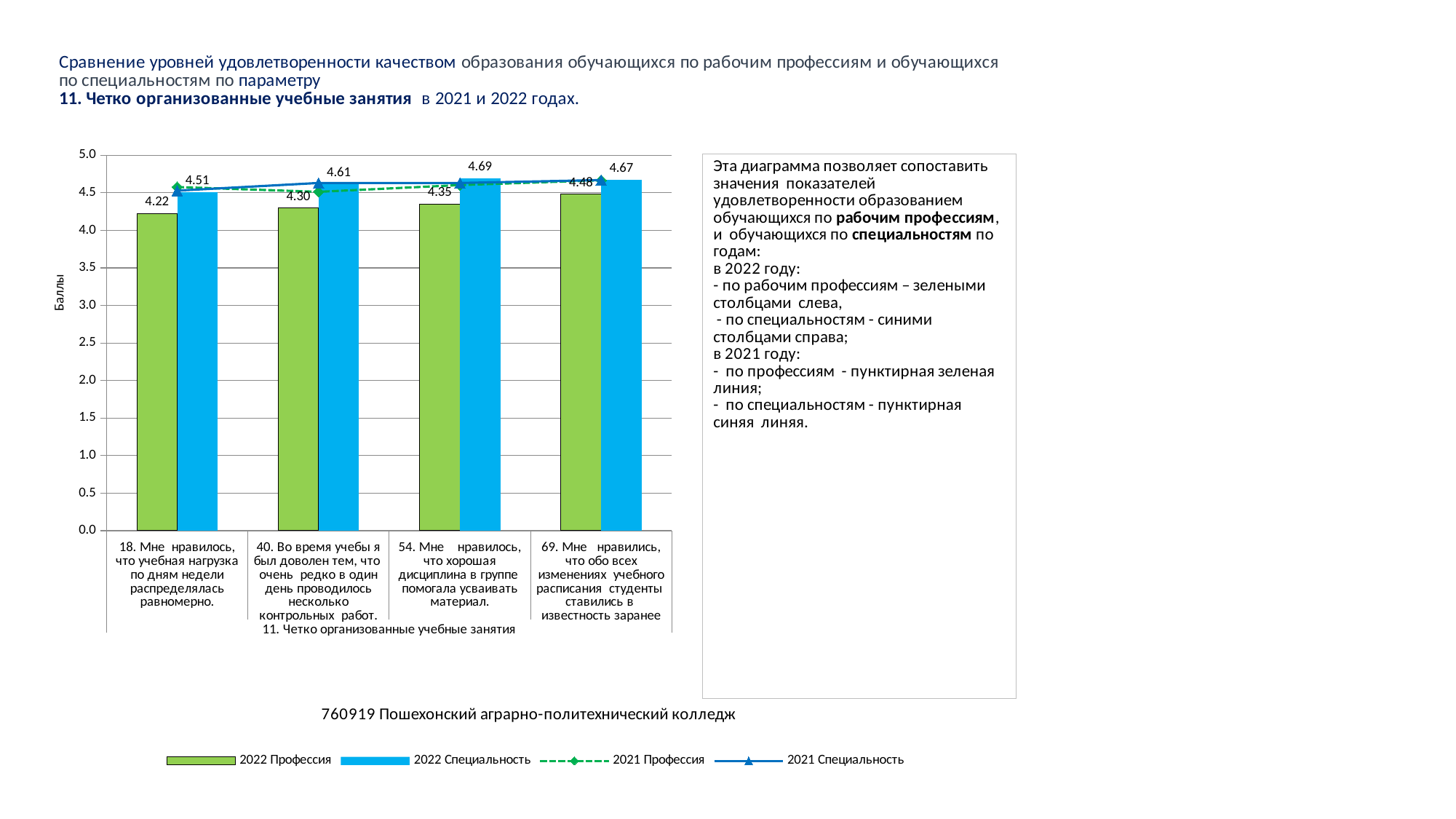
Which category has the lowest 2022 Специальность bar? 18. Мне нравилось, что учебная нагрузка по дням недели распределялась равномерно What is the value of the 2022 Специальность bar for category 54 (Мне нравилось, что хорошая дисциплина в группе помогала усваивать материал)? 4.69 What is the label of the y axis? Баллы What is the difference between the 2022 Специальность and 2022 Профессия bars for category 18? 0.29 How many categories are shown on the x axis? 4 What is the value of the 2022 Специальность bar for category 40 (Во время учебы я был доволен тем, что очень редко в один день проводилось несколько контрольных работ)? 4.61 Do the 2022 Профессия bar values rise or fall from left to right across the categories? rise How many series does the legend list? 4 For category 69, which is larger: the 2022 Профессия bar or the 2022 Специальность bar? 2022 Специальность Is the 2021 Профессия line value for category 18 greater or less than 4.0? greater Which category has the highest 2022 Профессия bar? 69. Мне нравились, что обо всех изменениях учебного расписания студенты ставились в известность заранее What is the value of the 2022 Профессия bar for category 18 (Мне нравилось, что учебная нагрузка по дням недели распределялась равномерно)? 4.22